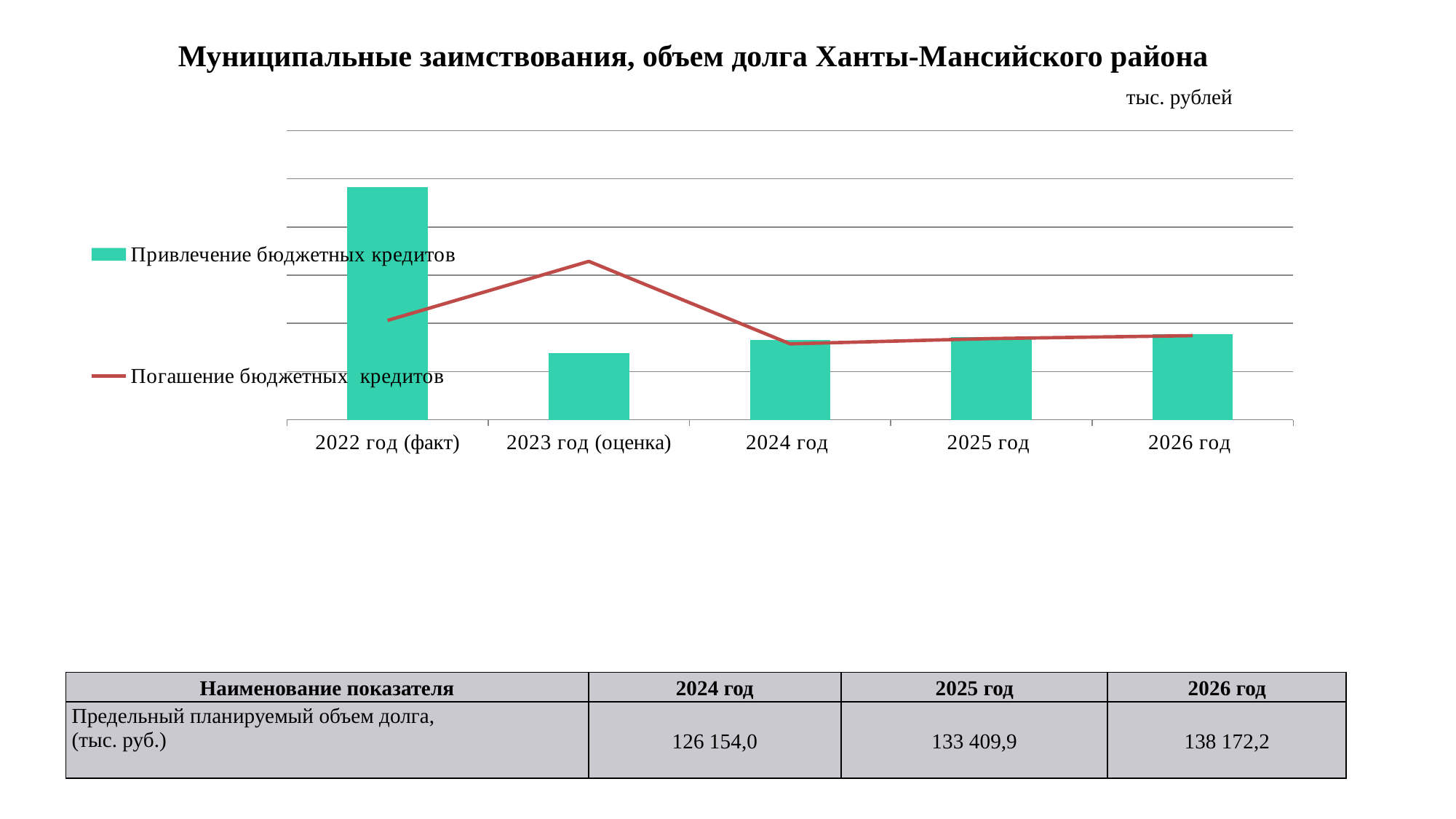
In 2023 год (оценка), which series has the larger value, Привлечение бюджетных кредитов or Погашение бюджетных кредитов? Погашение бюджетных кредитов Which year has the highest bar for Привлечение бюджетных кредитов? 2022 год (факт) Does the Погашение бюджетных кредитов line rise or fall from 2023 год (оценка) to 2024 год? Fall Which year has the lowest bar for Привлечение бюджетных кредитов? 2023 год (оценка) How many series does the chart legend list? 2 Which is larger, the Привлечение бюджетных кредитов bar for 2022 год (факт) or for 2023 год (оценка)? 2022 год (факт) What is the title of the chart? Муниципальные заимствования, объем долга Ханты-Мансийского района Which is larger, the Привлечение бюджетных кредитов bar for 2023 год (оценка) or for 2026 год? 2026 год What unit is indicated above the chart? тыс. рублей In which year does the Погашение бюджетных кредитов line reach its highest point? 2023 год (оценка) What kind of chart is shown on the slide? A combined bar and line chart How many year categories are shown on the x axis of the chart? 5